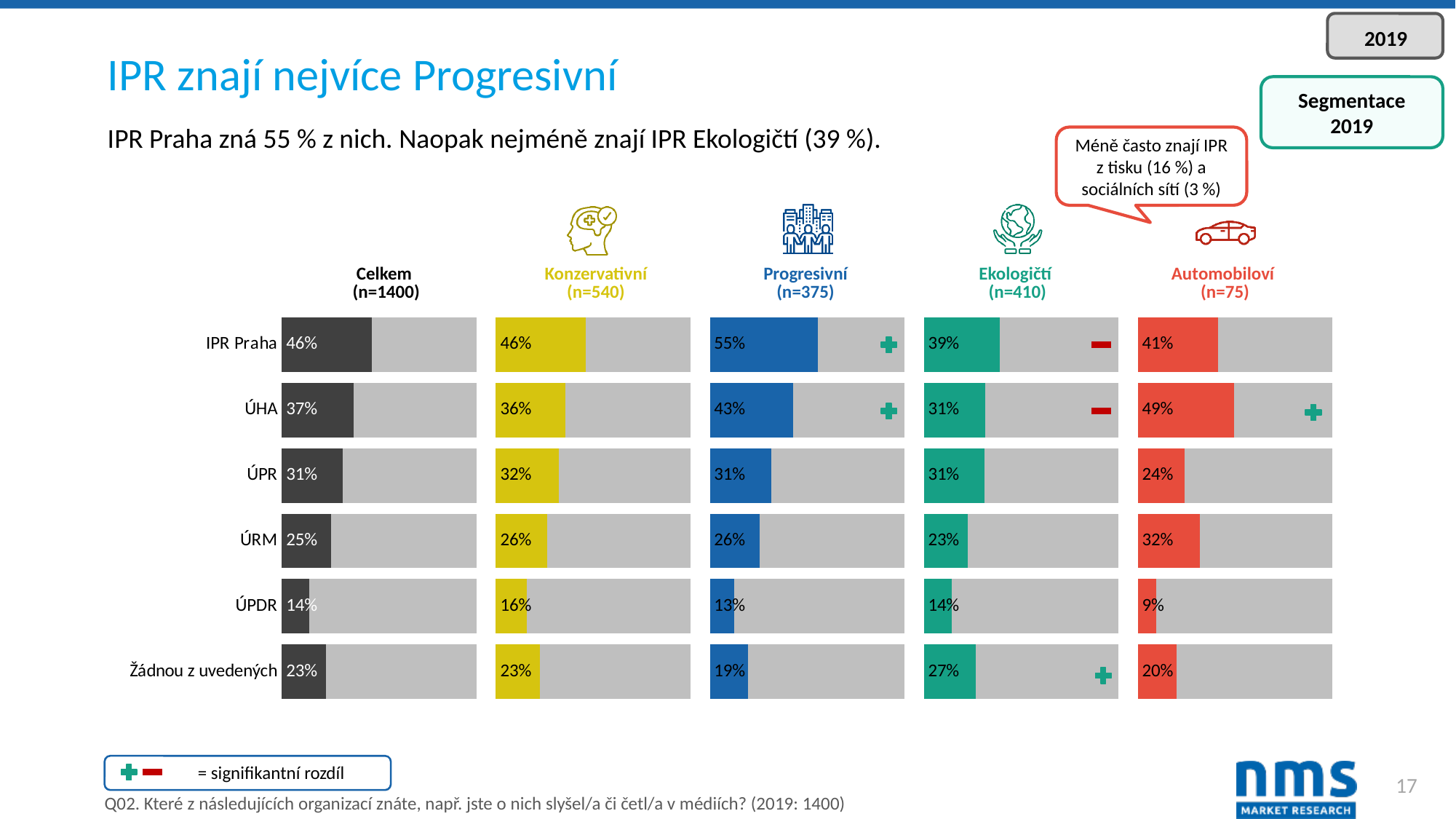
What colour are the bars in the Konzervativní (n=540) chart? Yellow In the Automobiloví (n=75) chart, which category has the highest value? ÚHA How many categories (organisations) are listed on the left of the bar charts? 6 In the Celkem (n=1400) chart, what is the value for IPR Praha? 46% What is the difference between the IPR Praha value in the Progresivní (n=375) chart and the IPR Praha value in the Ekologičtí (n=410) chart? 16 percentage points How many segment columns (charts) are shown on the slide, including Celkem? 5 What type of chart is used to show the values on this slide? Bar chart In the Konzervativní (n=540) chart, which category has the lowest value? ÚPDR In the Progresivní (n=375) chart, what is the value for ÚHA? 43% Which is larger: the ÚRM value in the Automobiloví (n=75) chart or the ÚRM value in the Celkem (n=1400) chart? Automobiloví (32%) In the Automobiloví (n=75) chart, what is the value for ÚPDR? 9% In the Ekologičtí (n=410) chart, which category has the highest value? IPR Praha